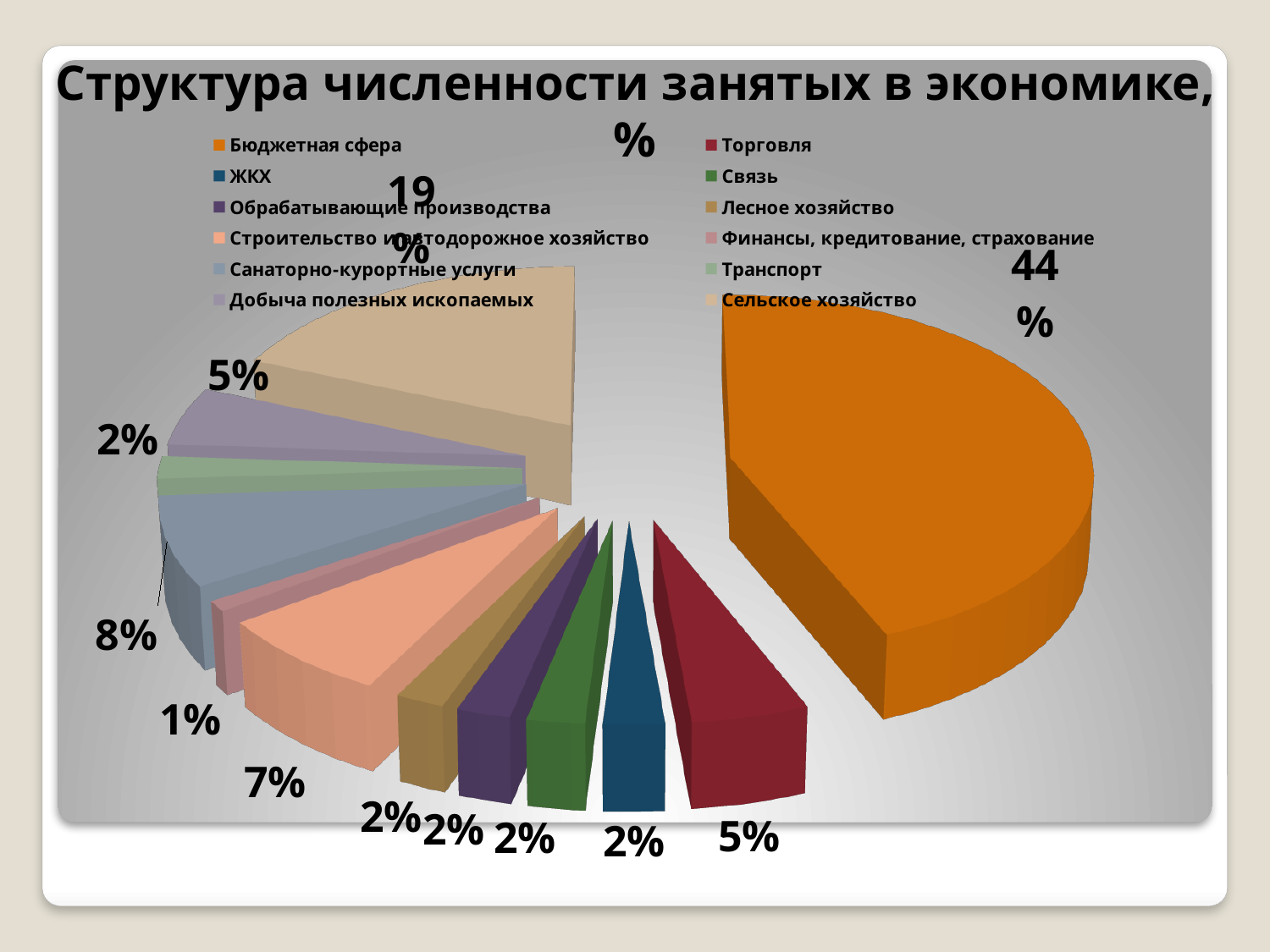
By how many percentage points does Бюджетная сфера exceed Сельское хозяйство? 25 percentage points What percentage is shown for Сельское хозяйство? 19% What share of those employed in the economy is in Бюджетная сфера? 44% What percentage is shown for Санаторно-курортные услуги? 8% What percentage is shown for Строительство и автодорожное хозяйство? 7% What type of chart is shown on the slide? pie chart Which category has the smallest share of the pie? Финансы, кредитование, страхование What percentage is shown for Торговля? 5% How many categories does the legend list? 12 What colour is the slice for Бюджетная сфера? orange Which category has the largest share of the pie? Бюджетная сфера Which is larger: the share for Санаторно-курортные услуги or for Строительство и автодорожное хозяйство? Санаторно-курортные услуги